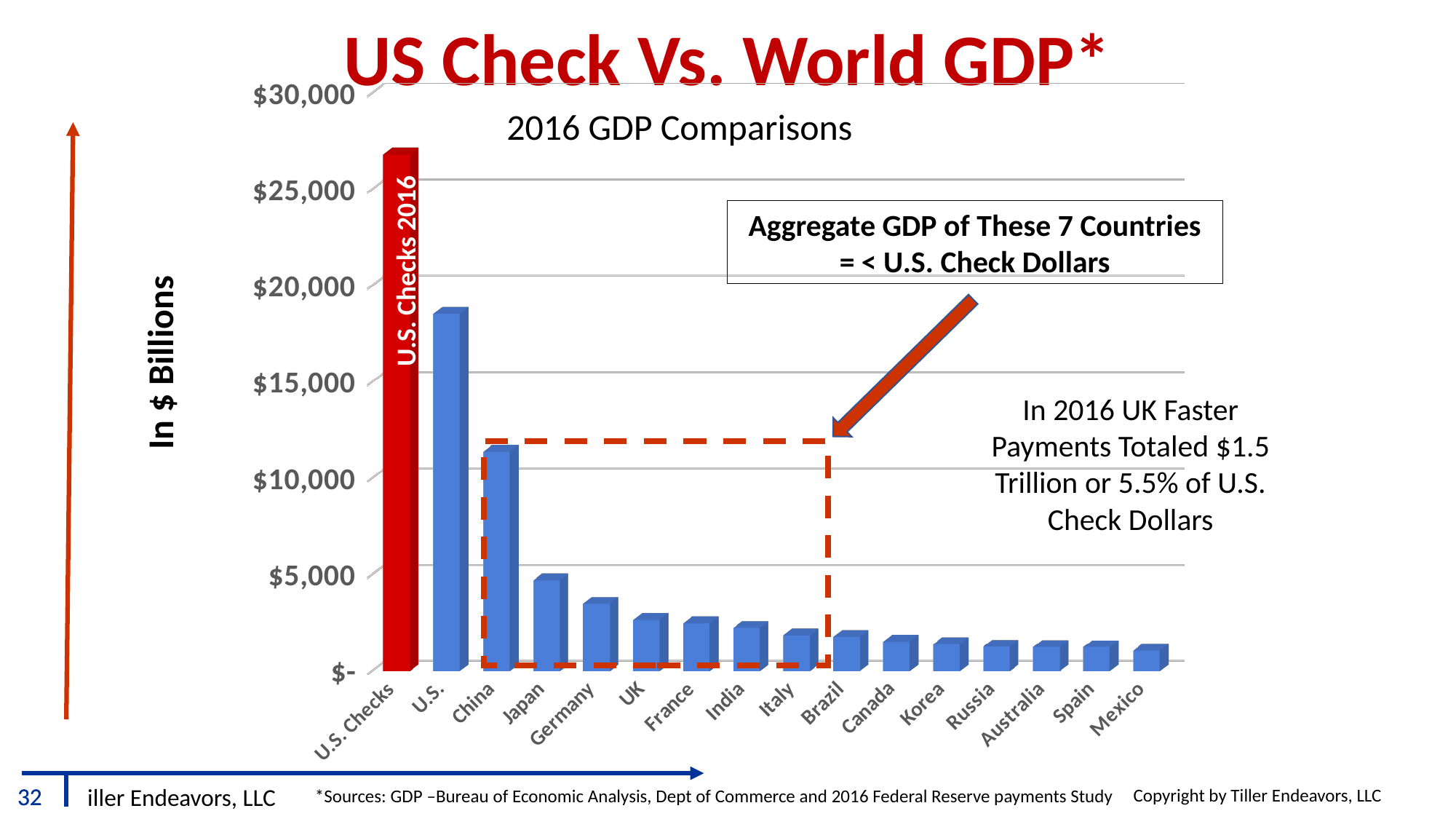
Which category has the tallest bar in the chart? U.S. Checks Is the value for U.S. greater or less than $20,000? less Is the value for Germany greater or less than $5,000? less Do the bar values rise or fall moving from left to right along the x axis? Fall What is the label on the vertical axis of the chart? In $ Billions Which is larger, the value for Japan or the value for Germany? Japan What kind of chart is shown on the slide? Bar chart How many categories are plotted along the x axis? 16 Is the value for China greater or less than $10,000? greater Which is larger, the value for U.S. or the value for China? U.S. Which category has the shortest bar in the chart? Mexico